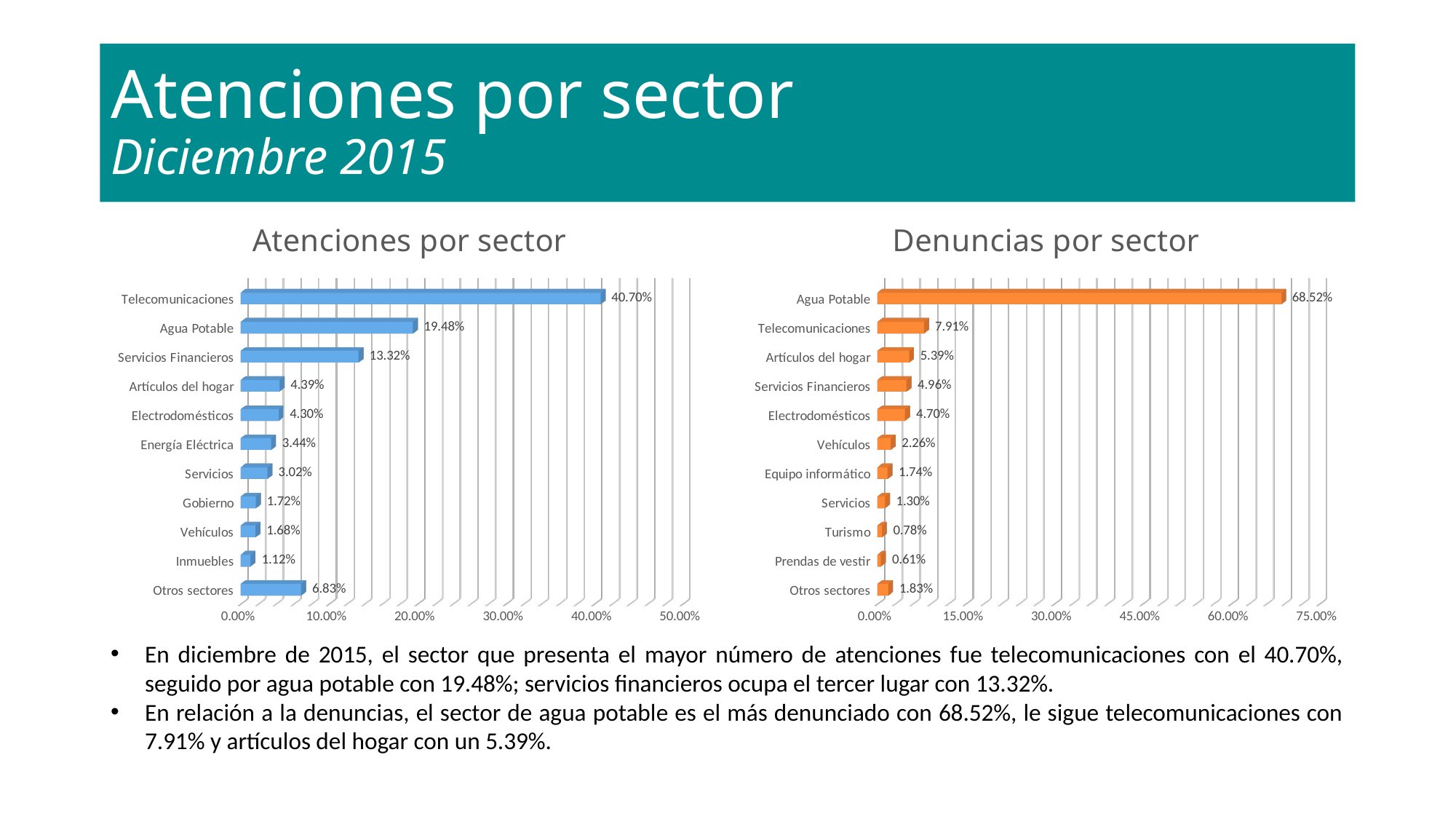
In the 'Atenciones por sector' chart, what is the value for Servicios Financieros? 13.32% In the 'Denuncias por sector' chart, what is the value for Equipo informático? 1.74% In the 'Atenciones por sector' chart, what is the difference between Telecomunicaciones and Agua Potable? 21.22% In the 'Denuncias por sector' chart, what is the difference between Telecomunicaciones and Artículos del hogar? 2.52% In the 'Atenciones por sector' chart, what is the value for Telecomunicaciones? 40.70% What type of chart is 'Atenciones por sector'? Bar chart In the 'Denuncias por sector' chart, which sector has the highest value? Agua Potable In the 'Atenciones por sector' chart, which is larger: Otros sectores or Artículos del hogar? Otros sectores In the 'Atenciones por sector' chart, which sector has the lowest value? Inmuebles How many sectors are shown in the 'Denuncias por sector' chart? 11 In the 'Denuncias por sector' chart, which sector has the lowest value? Prendas de vestir In the 'Denuncias por sector' chart, what is the value for Agua Potable? 68.52%